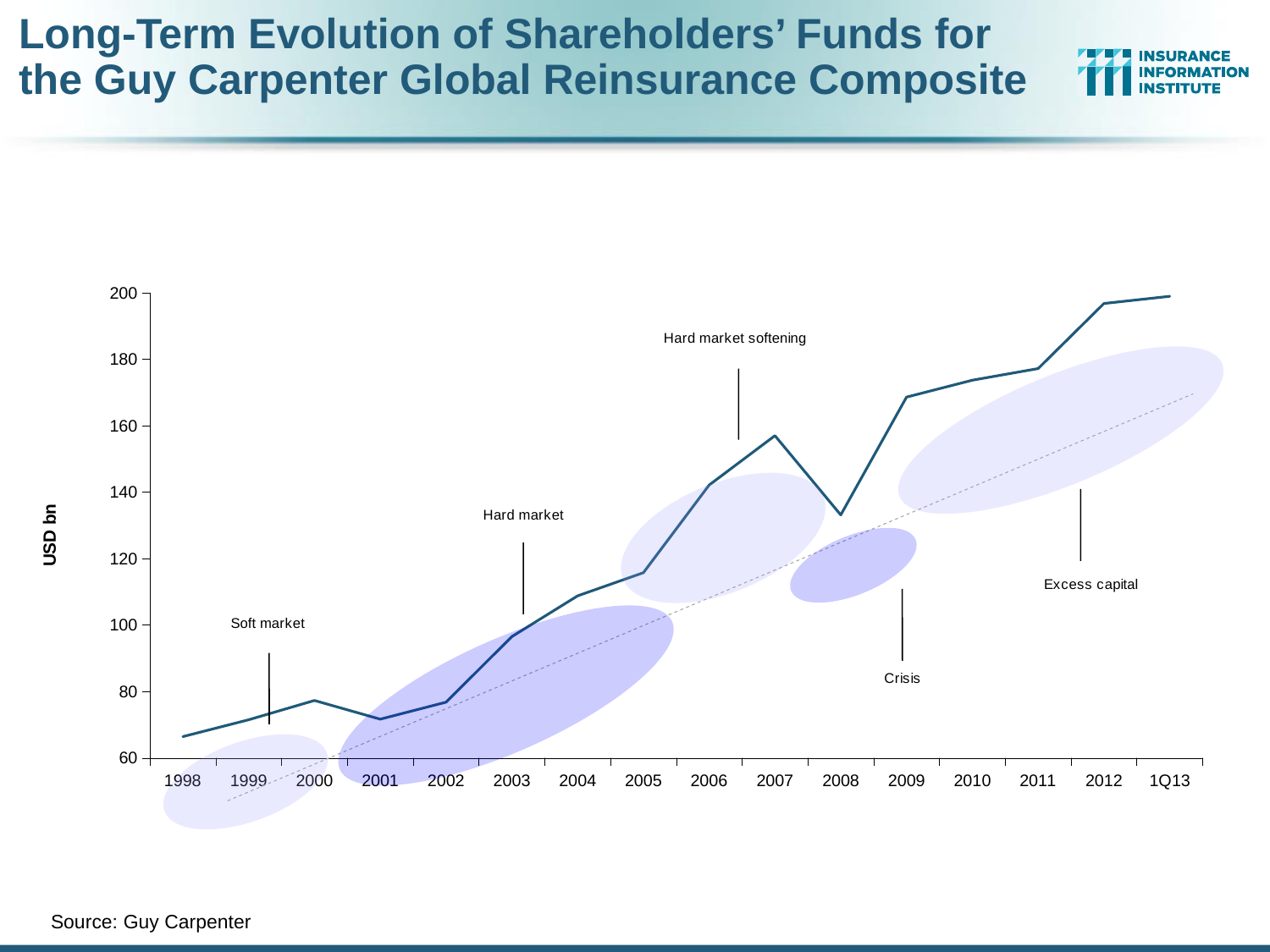
How many time points are plotted along the x axis? 16 Which is larger, the value for 2000 or the value for 2001? 2000 What is the label on the y axis? USD bn Overall, do shareholders' funds rise or fall from 1998 to 1Q13? Rise Which is larger, the value for 2007 or the value for 2008? 2007 Is the value for 2008 greater or less than 140? less Is the value for 2007 greater or less than 140? greater Is the value for 2001 greater or less than 80? less Which annotation is placed near the 2008 dip in the line? Crisis What kind of chart is shown on the slide? Line chart